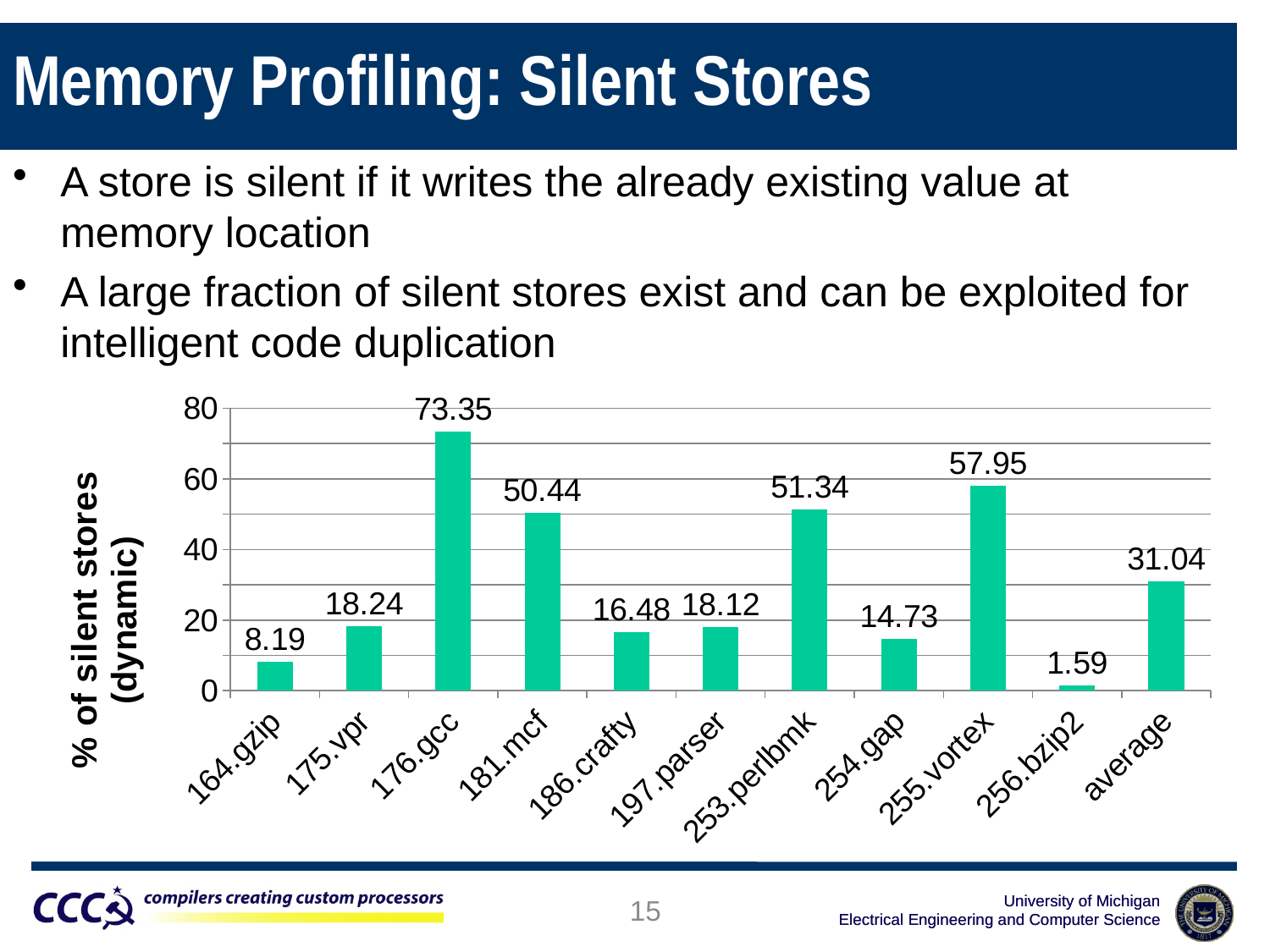
What is the percentage of silent stores for 256.bzip2? 1.59 What is the difference between the silent store percentages of 176.gcc and 255.vortex? 15.40 What kind of chart is shown on the slide? bar chart What is the percentage of silent stores for 176.gcc? 73.35 What is the label of the y axis of the chart? % of silent stores (dynamic) What is the percentage of silent stores for 164.gzip? 8.19 Which benchmark has the highest percentage of silent stores? 176.gcc How many bars are plotted in the chart, including the average? 11 Which has a higher percentage of silent stores, 181.mcf or 253.perlbmk? 253.perlbmk Is the value for 254.gap greater or less than 20? less What is the average percentage of silent stores shown in the chart? 31.04 Which benchmark has the lowest percentage of silent stores? 256.bzip2